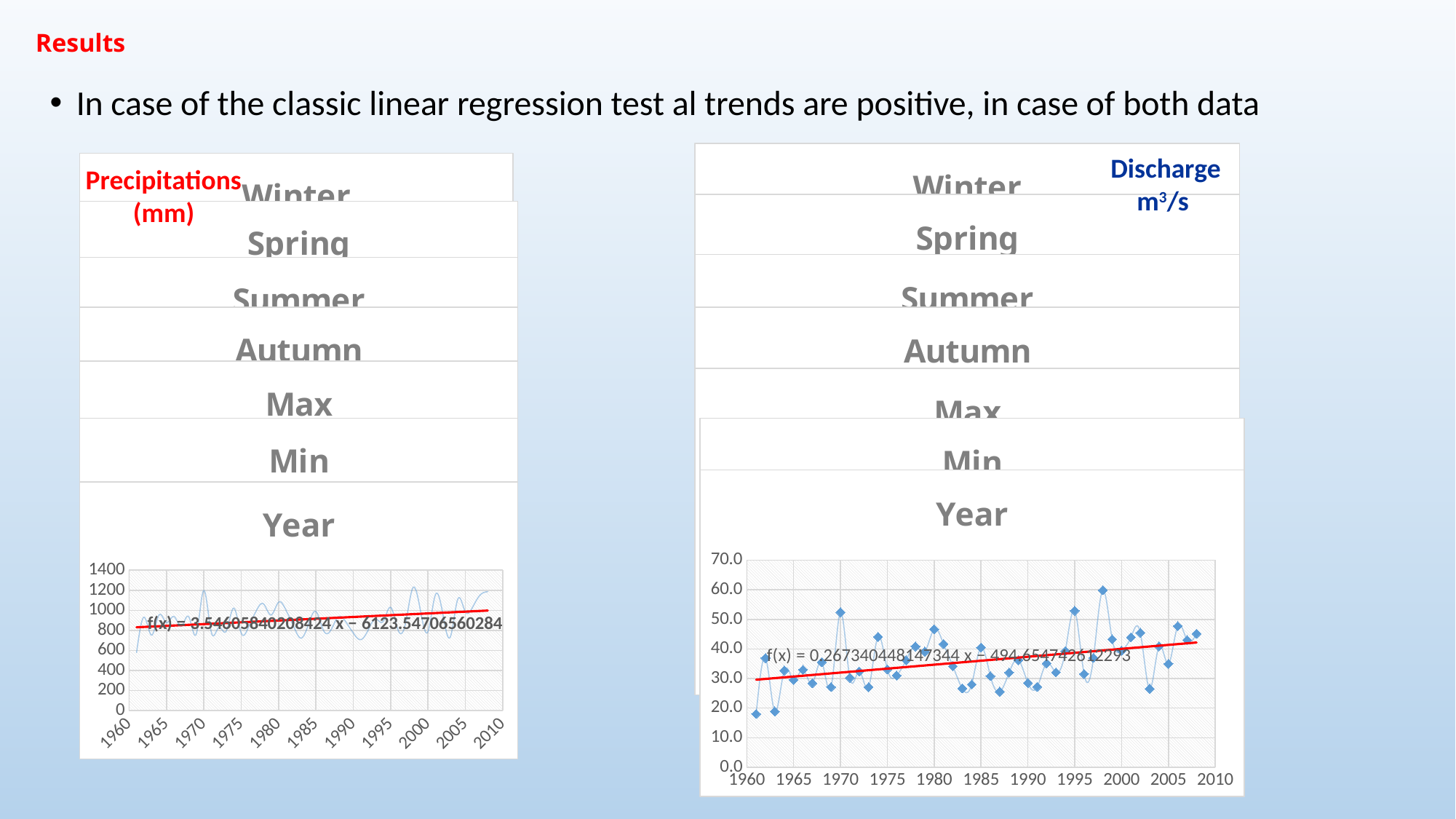
What unit is given for the discharge charts on the right side of the slide? m³/s What is the first year labelled on the x axis of the discharge 'Year' chart on the right? 1960 In the discharge 'Year' chart on the right, is the value for 1970 greater or less than 50.0? greater In the precipitation 'Year' chart on the left, does the red trend line rise or fall across the years? rises In the discharge 'Year' chart on the right, is the peak value around 1998 greater or less than 50.0? greater What is the highest value labelled on the y axis of the discharge 'Year' chart on the right? 70.0 What kind of chart is the precipitation 'Year' chart at the bottom left of the slide? line chart In the discharge 'Year' chart on the right, does the red trend line rise or fall from 1960 to 2010? rises In the discharge 'Year' chart on the right, is the value for 1961 greater or less than 20.0? less What is the last year labelled on the x axis of the precipitation 'Year' chart on the left? 2010 What is the highest value labelled on the y axis of the precipitation 'Year' chart on the left? 1400